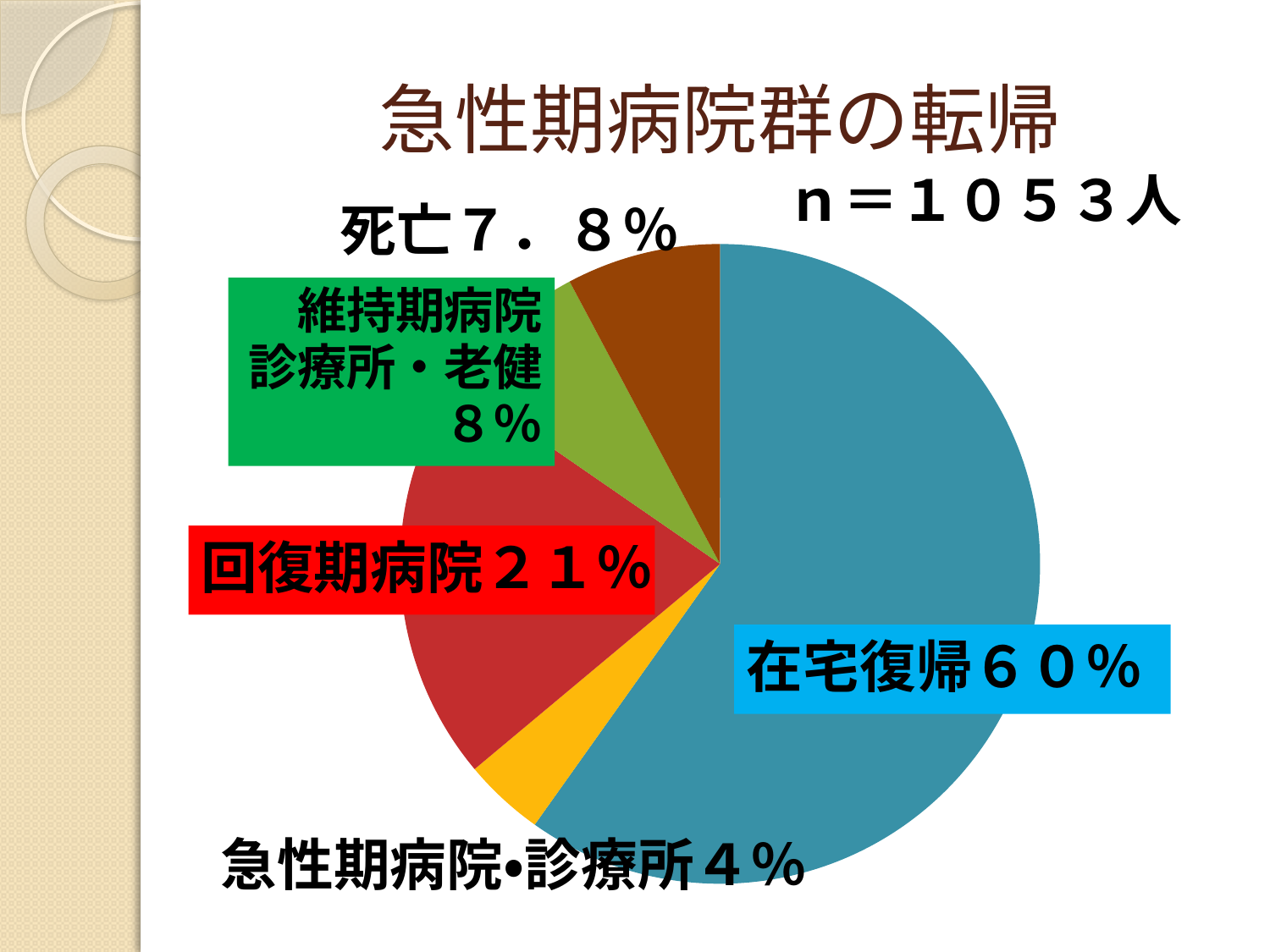
Which is larger, the share for 回復期病院 or the share for 死亡? 回復期病院 How many slices does the pie chart have? 5 What share of the pie is 維持期病院診療所・老健? ８％ Which category has the largest share of the pie? 在宅復帰 What is the sample size (n) shown on the slide? １０５３人 Which category has the smallest share of the pie? 急性期病院•診療所 What share of the pie is 死亡? ７．８％ What is the title of the chart? 急性期病院群の転帰 What share of the pie is 在宅復帰? ６０％ What kind of chart is shown on the slide? pie chart